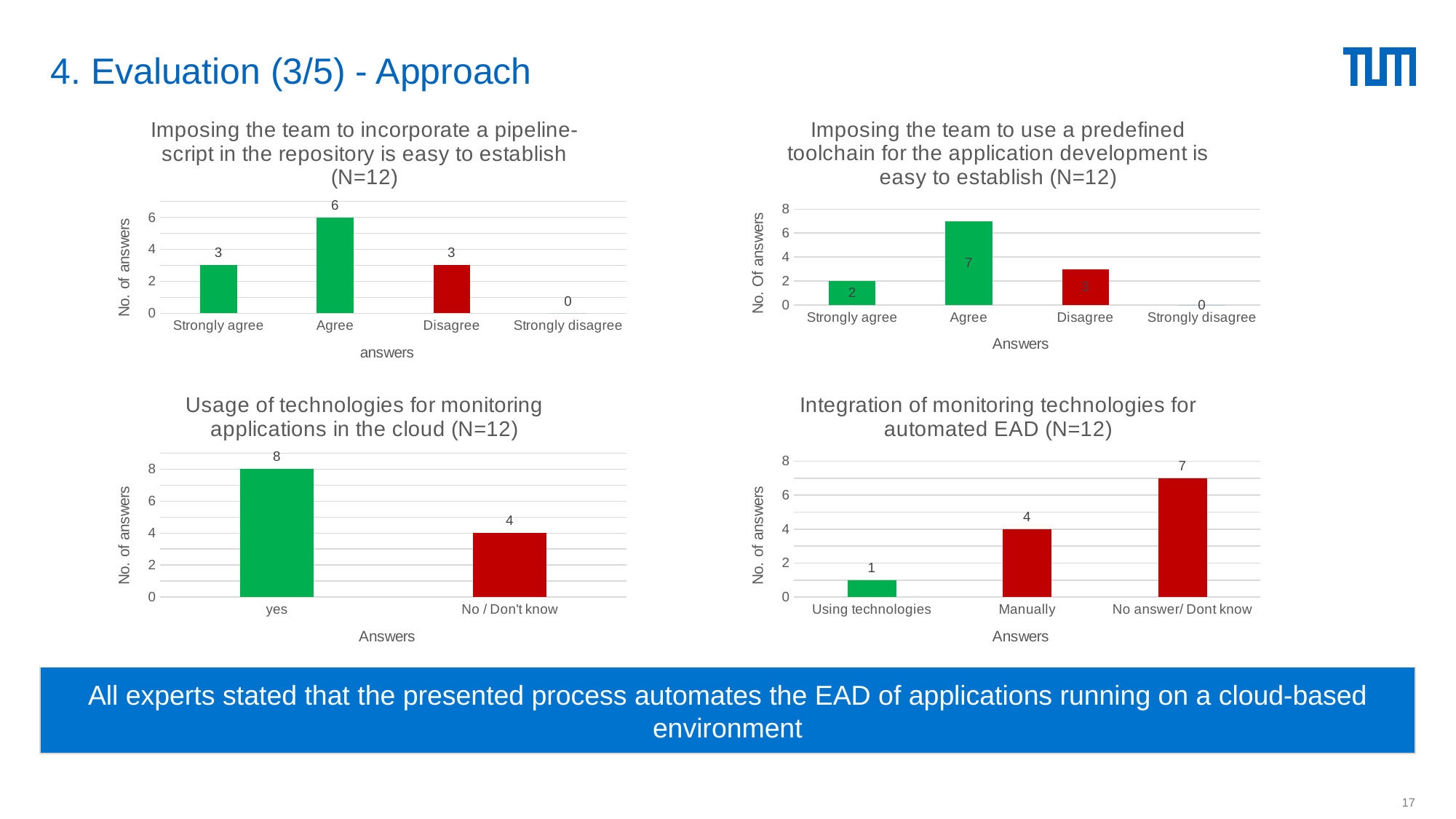
In the bottom-right chart (integration of monitoring technologies), what is the difference between 'No answer/ Dont know' and 'Using technologies'? 6 In the bottom-right chart (integration of monitoring technologies), how many answers were 'Manually'? 4 In the top-right chart (predefined toolchain), how many answers were 'Strongly agree'? 2 In the top-left chart (pipeline-script in the repository), which answer category has the highest number of answers? Agree In the top-left chart (pipeline-script in the repository), how many answer categories are shown on the x axis? 4 In the top-right chart (predefined toolchain), what is the difference between the number of 'Agree' and 'Disagree' answers? 4 In the top-left chart (pipeline-script in the repository), how many answers were 'Agree'? 6 What type of chart is the bottom-left chart (usage of monitoring technologies)? Bar chart In the bottom-right chart (integration of monitoring technologies), which category has the highest number of answers? No answer/ Dont know In the top-right chart (predefined toolchain), which answer category has the lowest number of answers? Strongly disagree In the bottom-left chart (usage of monitoring technologies), how many answers were 'yes'? 8 In the bottom-left chart (usage of monitoring technologies), which is larger: 'yes' or 'No / Don't know'? yes